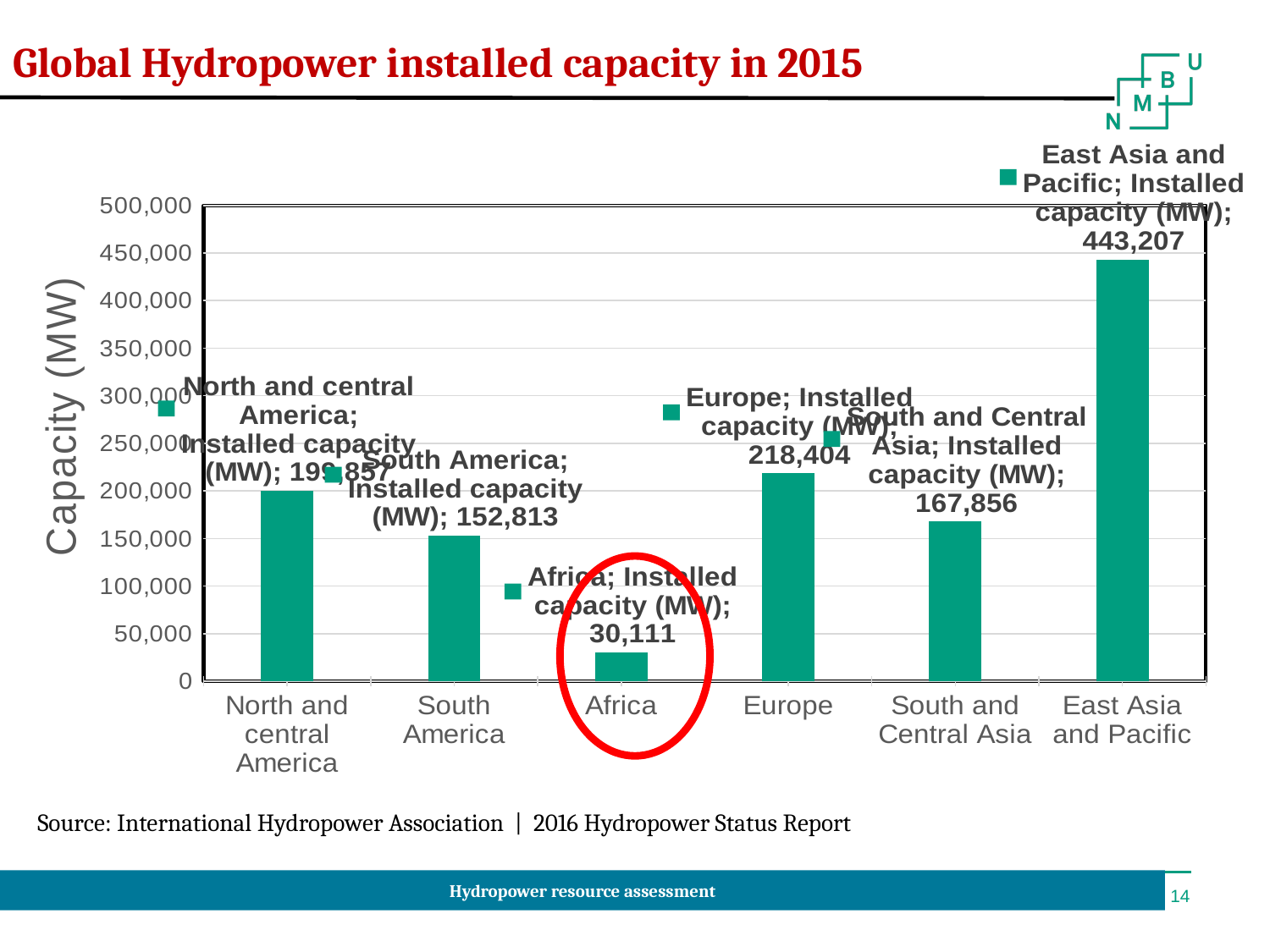
What is the difference in installed capacity (MW) between Europe and Africa? 188,293 Which has a larger installed capacity, Europe or South and Central Asia? Europe Is the installed capacity for North and central America greater or less than 150,000? greater Which region has the highest installed capacity? East Asia and Pacific Which region has the lowest installed capacity? Africa What is the installed capacity (MW) for South and Central Asia? 167,856 What is the installed capacity (MW) for Europe? 218,404 How many regions are shown on the x axis of the chart? 6 What is the installed capacity (MW) for Africa? 30,111 What is the installed capacity (MW) for East Asia and Pacific? 443,207 What type of chart is shown on the slide? bar chart What is the installed capacity (MW) for South America? 152,813